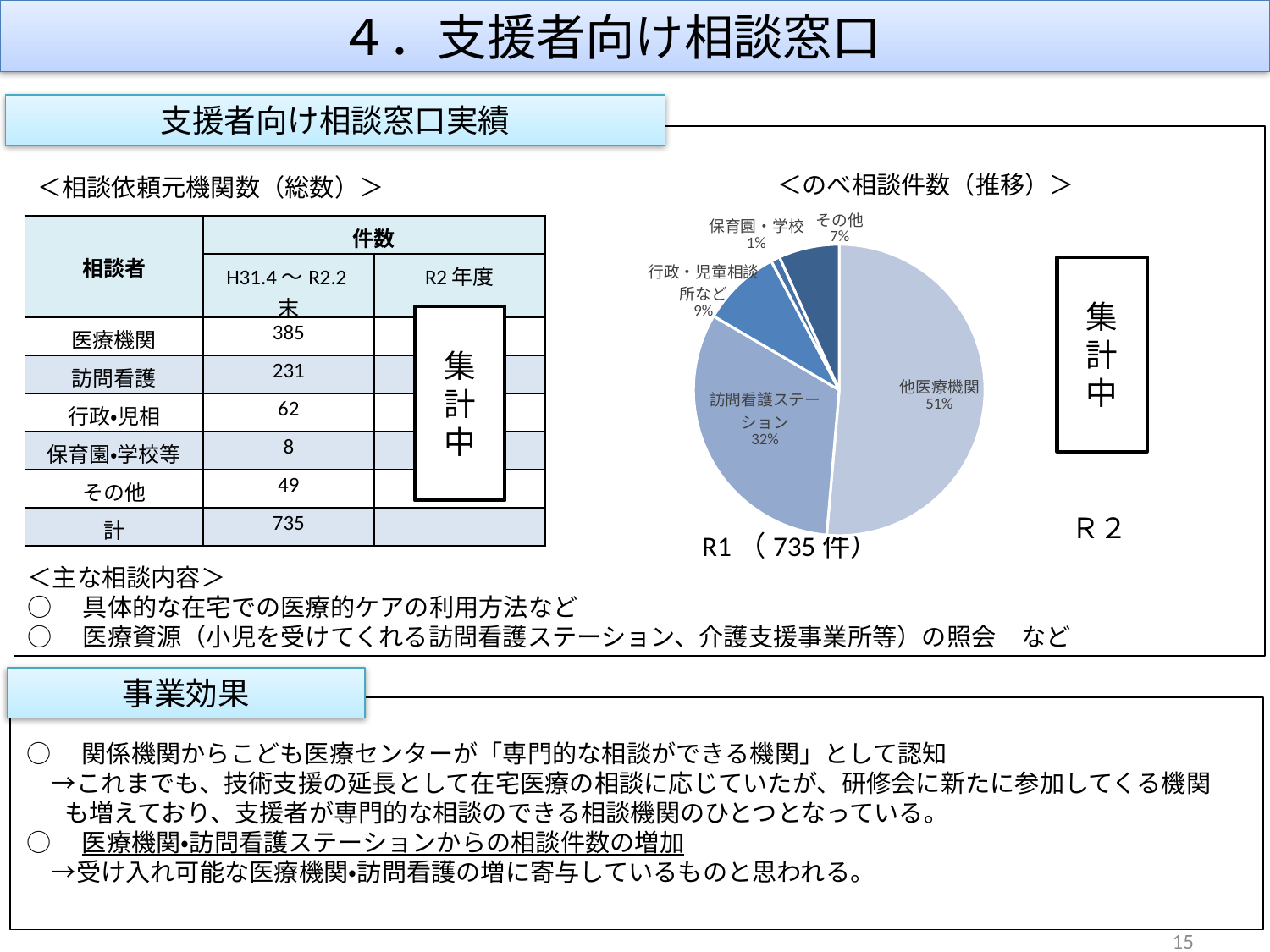
What total number of cases is shown below the pie chart for R1? 735 件 In the pie chart, what share is shown for 訪問看護ステーション? 32% In the pie chart, what is the difference in percentage points between 他医療機関 and 訪問看護ステーション? 19 Which slice of the pie chart is the smallest? 保育園・学校 What kind of chart is shown under the heading <のべ相談件数（推移）>? pie chart Which slice of the pie chart is the largest? 他医療機関 How many slices does the pie chart have? 5 In the pie chart, which is larger: その他 or 行政・児童相談所など? 行政・児童相談所など In the pie chart, what share is shown for 保育園・学校? 1% In the pie chart, what share is shown for 行政・児童相談所など? 9% In the pie chart, what share is shown for その他? 7% In the pie chart, what share is shown for 他医療機関? 51%